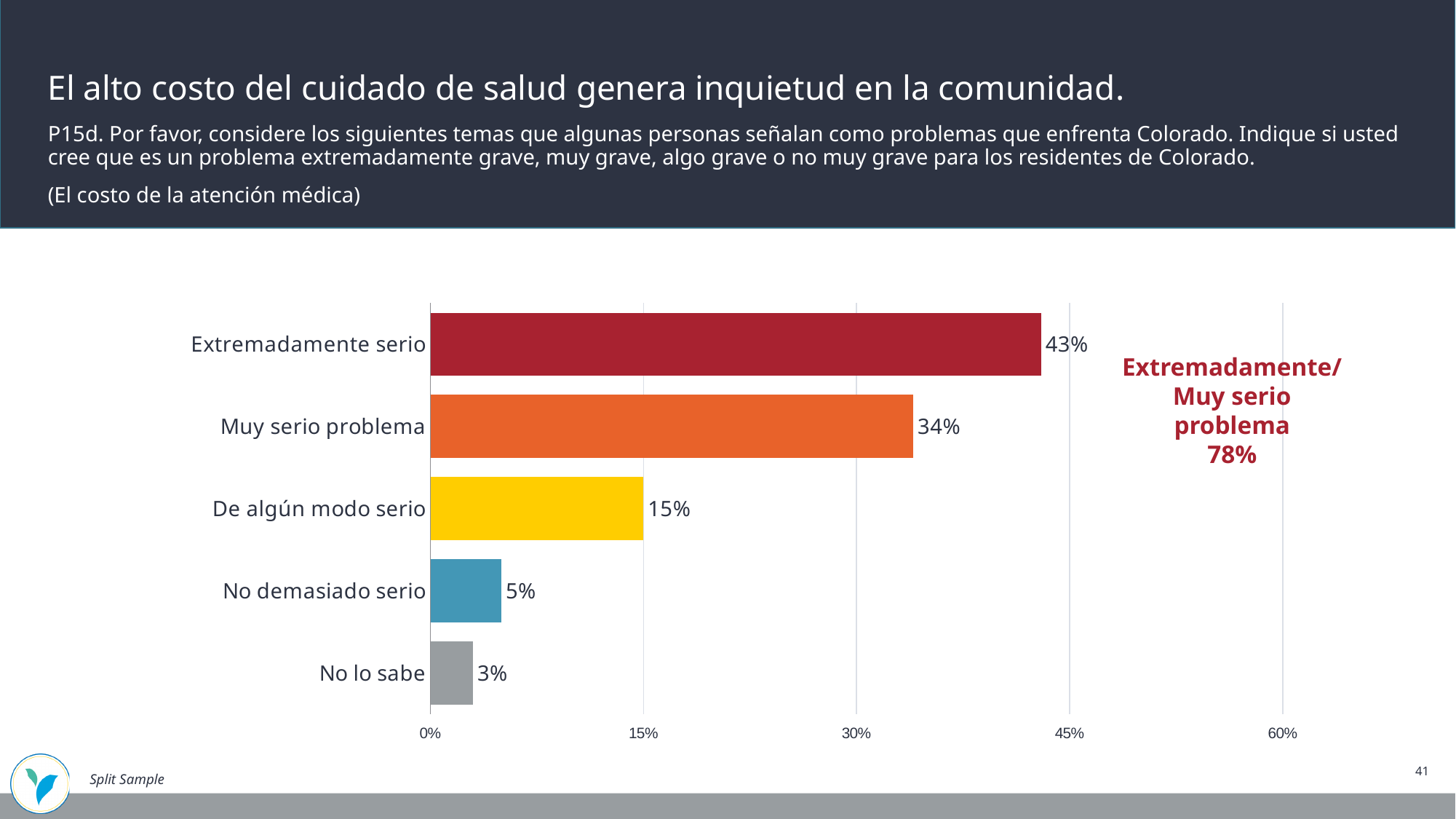
Is the value for "Muy serio problema" greater or less than 30%? greater What is the value for "No lo sabe"? 3% Which category has the lowest value? No lo sabe Which category has the highest value? Extremadamente serio What is the value for "Muy serio problema"? 34% What is the value for "De algún modo serio"? 15% What kind of chart is shown on the slide? bar chart How many categories are shown in the chart? 5 What combined percentage is shown in the red annotation for "Extremadamente/Muy serio problema"? 78% Which is larger, the value for "De algún modo serio" or the value for "No demasiado serio"? De algún modo serio What is the value for "Extremadamente serio"? 43% What is the difference between the values for "Extremadamente serio" and "Muy serio problema"? 9%